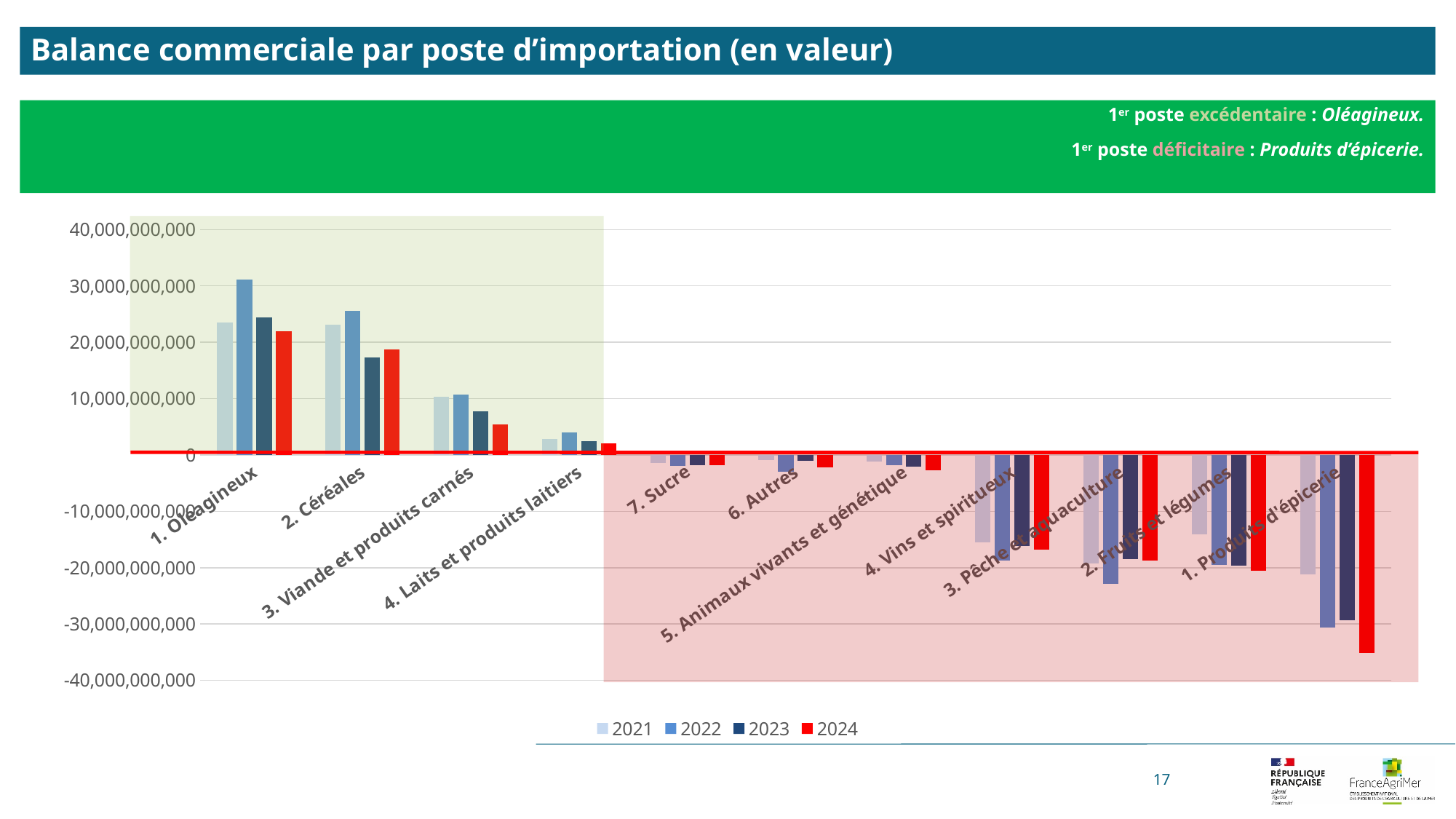
Which is larger, the 2022 value for 1. Oléagineux or the 2022 value for 2. Céréales? 1. Oléagineux Is the 2022 value for 1. Oléagineux greater or less than 20,000,000,000? greater What colour represents the 2024 series in the legend? Red Which category has the lowest value for the 2024 series? 1. Produits d'épicerie Which category has the highest value for the 2022 series? 1. Oléagineux Is the 2023 value for 2. Céréales greater or less than 20,000,000,000? less Do the values generally rise or fall moving from left to right along the x axis? Fall How many series does the legend list? 4 Is the 2024 value for 4. Vins et spiritueux greater or less than -10,000,000,000? less What kind of chart is shown on the slide? Bar chart How many categories are plotted along the x axis? 11